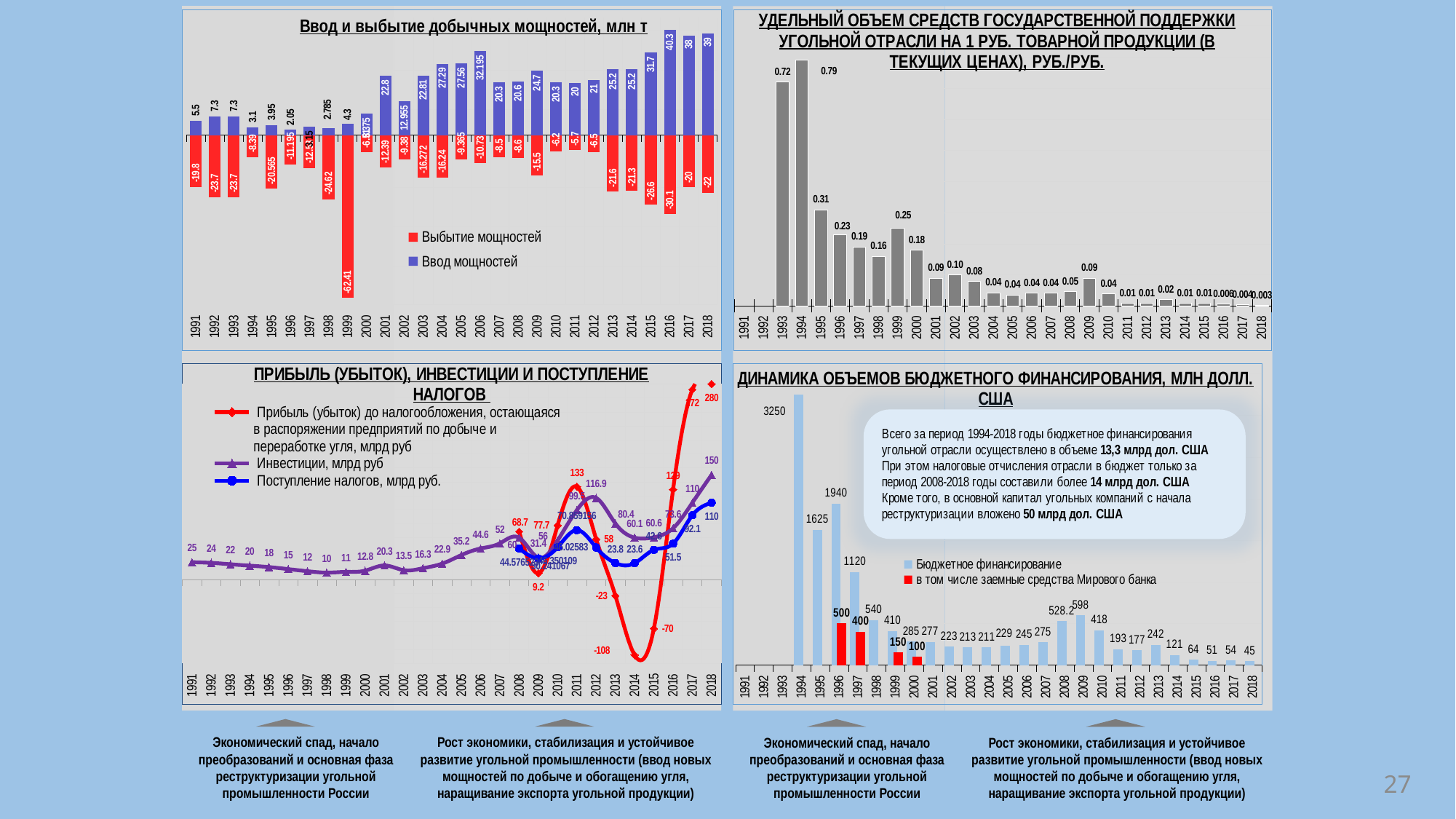
On the chart 'Ввод и выбытие добычных мощностей, млн т', what is the value of Ввод мощностей for 2016? 40.3 What kind of chart is 'Прибыль (убыток), инвестиции и поступление налогов'? line chart On the chart 'Динамика объемов бюджетного финансирования, млн долл. США', which is larger: Бюджетное финансирование in 2008 or in 2009? 2009 On the top-right chart (Удельный объем средств государственной поддержки), which year has the highest value? 1994 On the chart 'Ввод и выбытие добычных мощностей, млн т', how many series does the legend list? 2 On the chart 'Динамика объемов бюджетного финансирования, млн долл. США', what is the value of Бюджетное финансирование for 1994? 3250 On the top-right chart (Удельный объем средств государственной поддержки), what is the difference between the values for 1993 and 1995? 0.41 On the chart 'Прибыль (убыток), инвестиции и поступление налогов', what is the value of Инвестиции, млрд руб for 1991? 25 On the chart 'Ввод и выбытие добычных мощностей, млн т', which year has the highest value of Ввод мощностей? 2016 On the chart 'Динамика объемов бюджетного финансирования, млн долл. США', what is the value of заемные средства Мирового банка for 1996? 500 On the chart 'Ввод и выбытие добычных мощностей, млн т', what is the value of Выбытие мощностей for 1999? -62.41 On the top-right chart (Удельный объем средств государственной поддержки), what is the value for 1994? 0.79